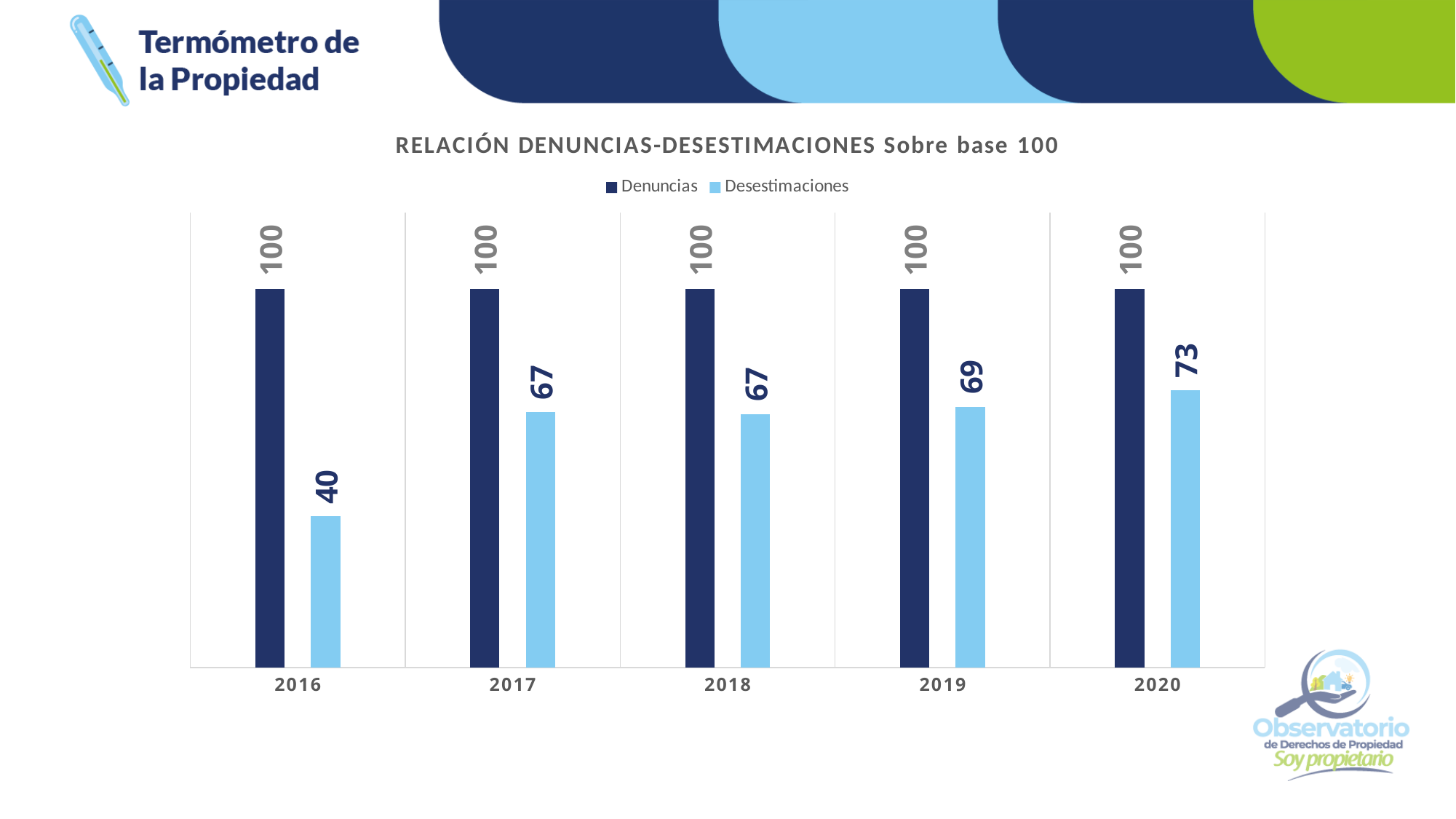
What is the difference between Denuncias and Desestimaciones in 2016? 60 Which year has the lowest value for Desestimaciones? 2016 How many series does the legend list? 2 What is the value of Desestimaciones for 2020? 73 What kind of chart is shown on the slide? Bar chart How many years are shown on the x axis? 5 Which year has the highest value for Desestimaciones? 2020 What is the difference between the Desestimaciones values for 2020 and 2019? 4 What is the value of Desestimaciones for 2016? 40 What is the value of Denuncias for 2018? 100 Which is larger, the Desestimaciones value for 2017 or for 2016? 2017 Do the Desestimaciones values generally rise or fall from 2016 to 2020? Rise